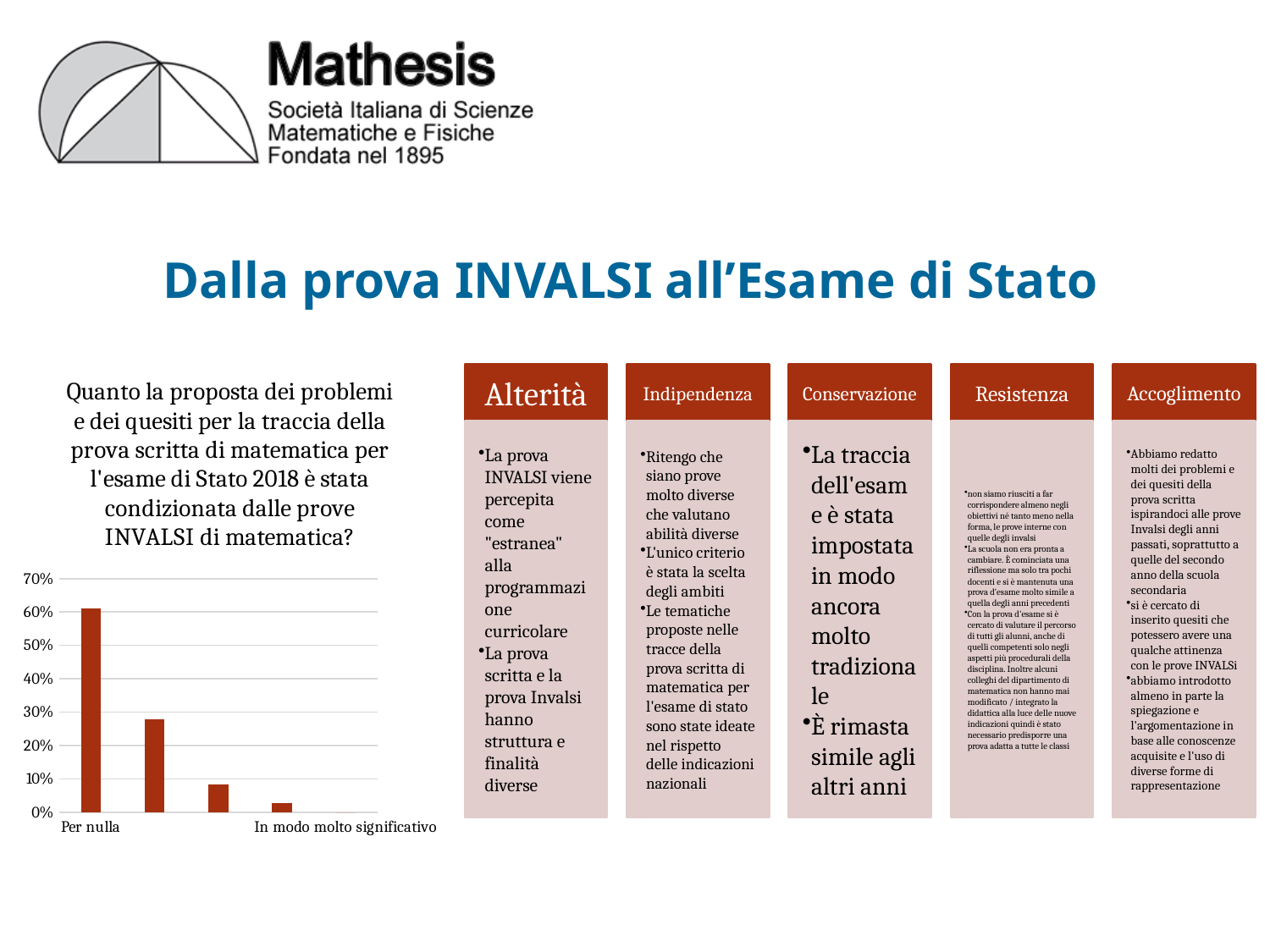
Which is larger, the value for "Per nulla" or the value for "In modo molto significativo"? Per nulla Is the value for "In modo molto significativo" greater or less than 10%? less What is the highest tick value shown on the chart's vertical axis? 70% What colour are the bars in the chart? dark red What kind of chart is shown on the slide? bar chart Is the value for "Per nulla" greater or less than 50%? greater Which category has the lowest bar in the chart? In modo molto significativo Do the bar values rise or fall moving from left to right along the x axis? fall Which category has the highest bar in the chart? Per nulla